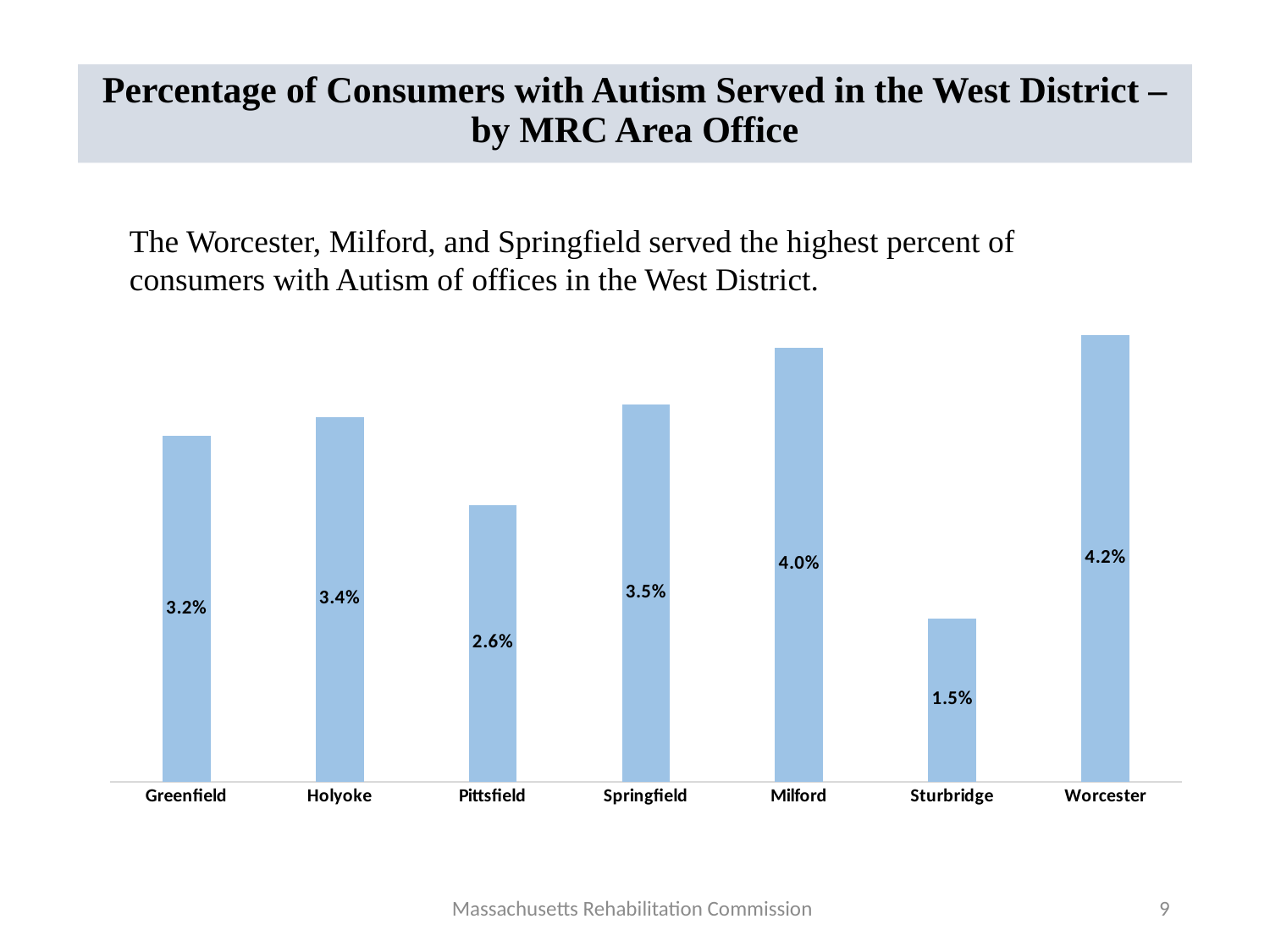
Which office served a higher percentage of consumers with Autism, Springfield or Holyoke? Springfield What is the difference in percentage points between the Worcester and Sturbridge offices? 2.7 What is the difference in percentage points between the Holyoke and Greenfield offices? 0.2 What type of chart is shown on the slide? Bar chart What percentage of consumers with Autism were served by the Milford office? 4.0% What percentage of consumers with Autism were served by the Sturbridge office? 1.5% What is the title of the chart on the slide? Percentage of Consumers with Autism Served in the West District – by MRC Area Office Which area office has the lowest percentage of consumers with Autism served? Sturbridge What percentage of consumers with Autism were served by the Pittsfield office? 2.6% What percentage of consumers with Autism were served by the Greenfield office? 3.2% How many area offices are shown in the chart? 7 Which area office has the highest percentage of consumers with Autism served? Worcester